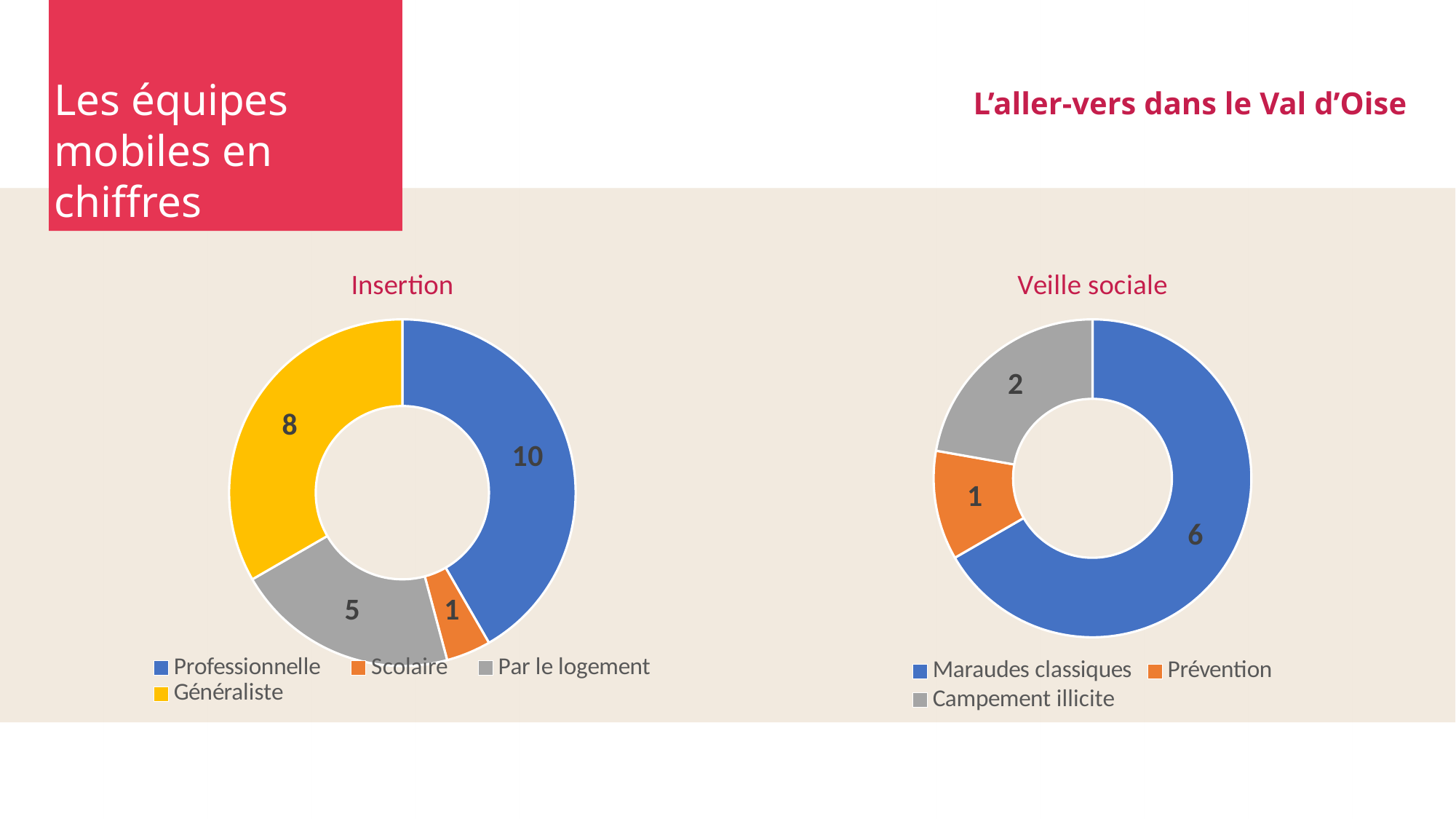
In the 'Insertion' chart, what is the value for Professionnelle? 10 In the 'Veille sociale' chart, what is the value for Campement illicite? 2 In the 'Insertion' chart, what is the value for Généraliste? 8 In the 'Veille sociale' chart, what is the value for Maraudes classiques? 6 In the 'Insertion' chart, what is the total of all slices? 24 In the 'Veille sociale' chart, which category has the highest value? Maraudes classiques In the 'Insertion' chart, what is the difference between Professionnelle and Par le logement? 5 In the 'Insertion' chart, how many categories are shown? 4 In the 'Insertion' chart, which category has the lowest value? Scolaire In the 'Veille sociale' chart, which is larger: Prévention or Campement illicite? Campement illicite In the 'Veille sociale' chart, what share of the total does Maraudes classiques represent? 2/3 What type of chart is the 'Veille sociale' chart? Doughnut chart